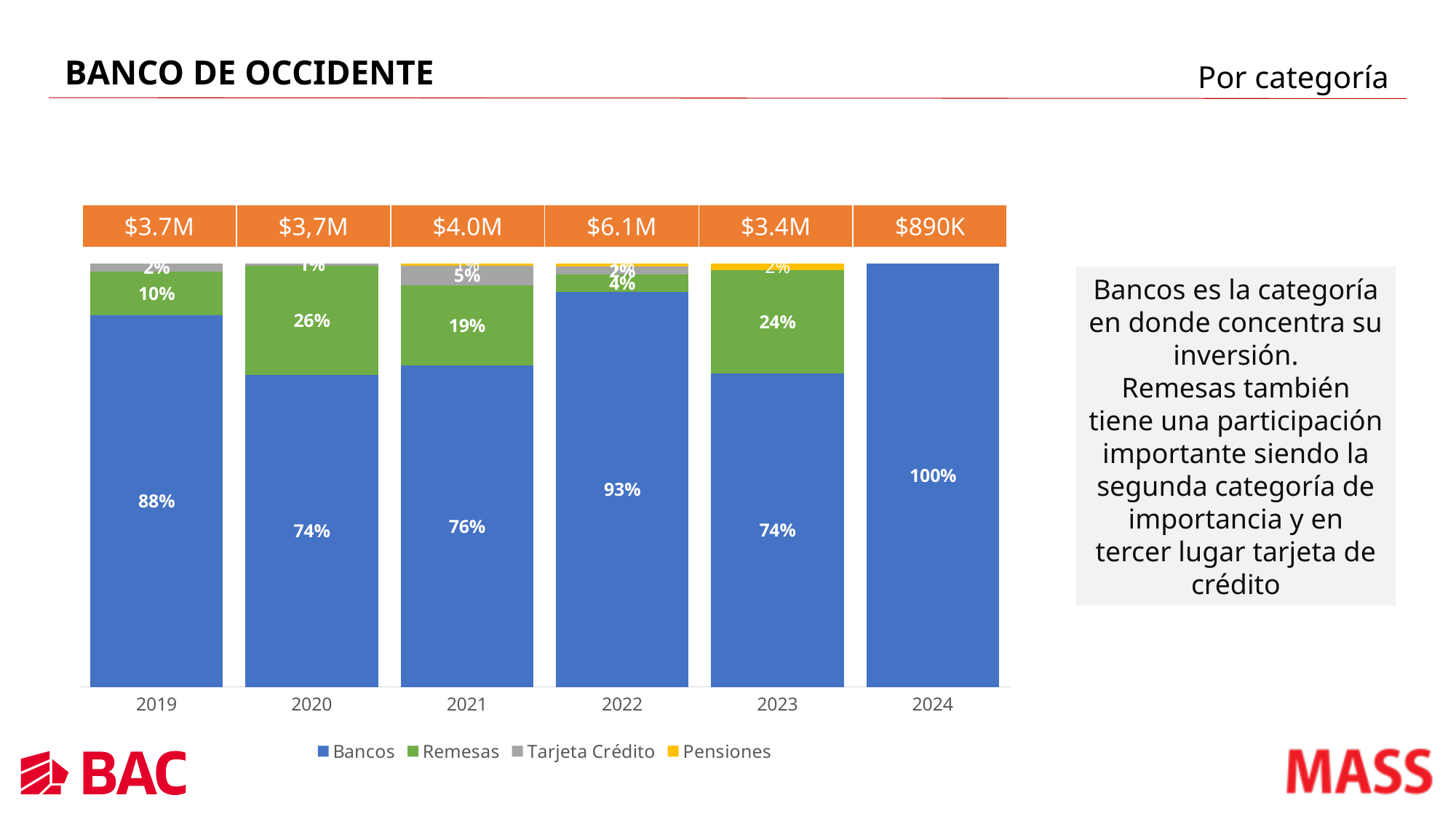
Is the Remesas share larger in 2021 or in 2019? 2021 What is the Remesas share for 2023? 24% What kind of chart is shown on the slide? Stacked bar chart What is the Bancos share for 2019? 88% What total amount is shown above the 2022 bar? $6.1M How many series does the legend list? 4 Which year has the highest Remesas share? 2020 What is the Bancos share for 2022? 93% What is the Remesas share for 2020? 26% Which year has the highest Bancos share? 2024 What is the difference between the Bancos share in 2022 and in 2023? 19 percentage points What is the Tarjeta Crédito share for 2021? 5%